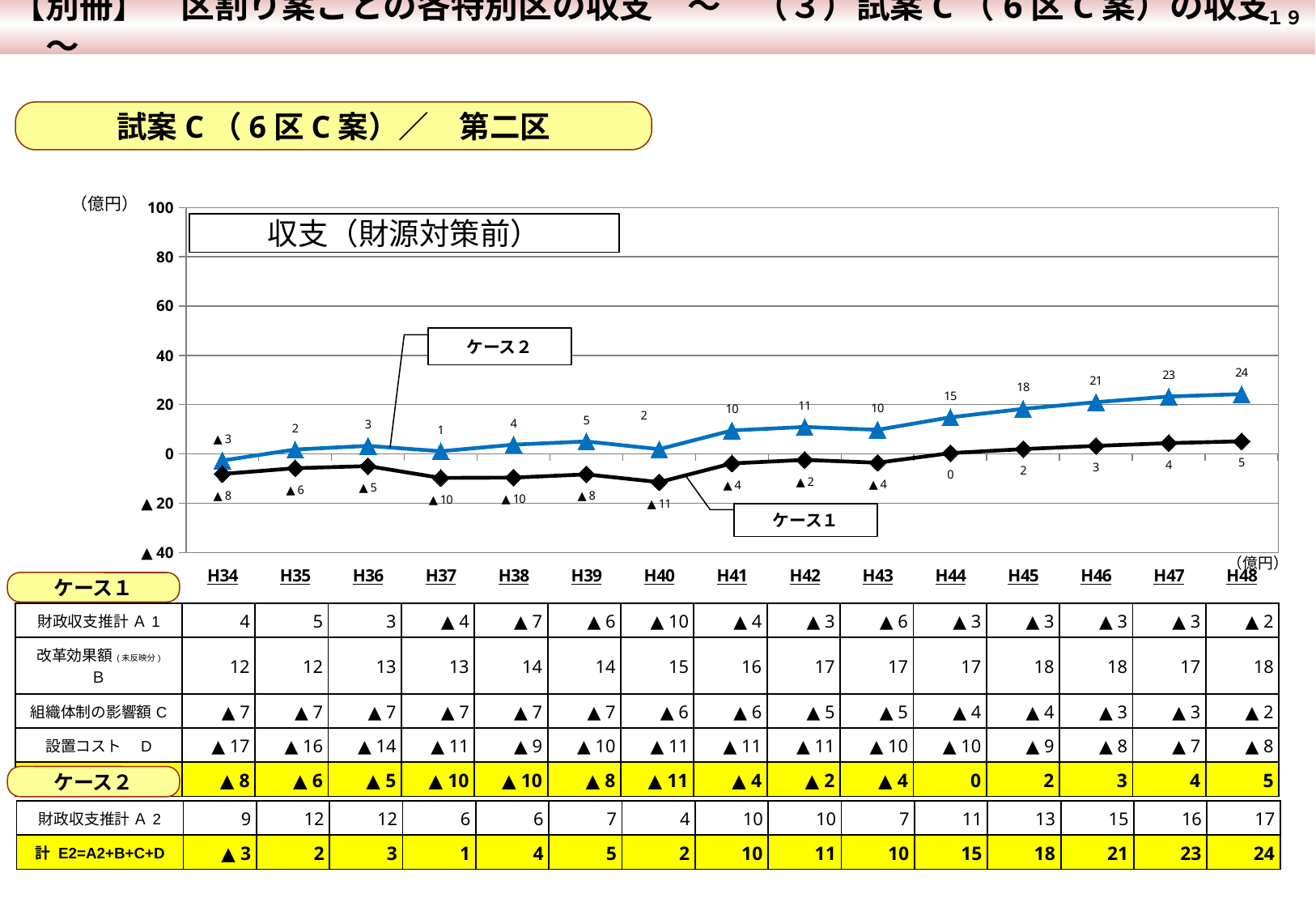
How many years (points) are plotted along the x axis of the chart? 15 What is the value of ケース1 at H40? ▲11 At H42, which series has the larger value, ケース1 or ケース2? ケース2 How many series are plotted in the chart? 2 In which year does ケース1 reach its lowest value? H40 What kind of chart is shown on the slide? line chart What is the value of ケース2 at H48? 24 What is the value of ケース1 at H44? 0 What is the difference between ケース2 and ケース1 at H48? 19 In which year does ケース2 reach its highest value? H48 Does ケース2 rise or fall from H44 to H48? rise What is the title shown inside the chart area? 収支（財源対策前）